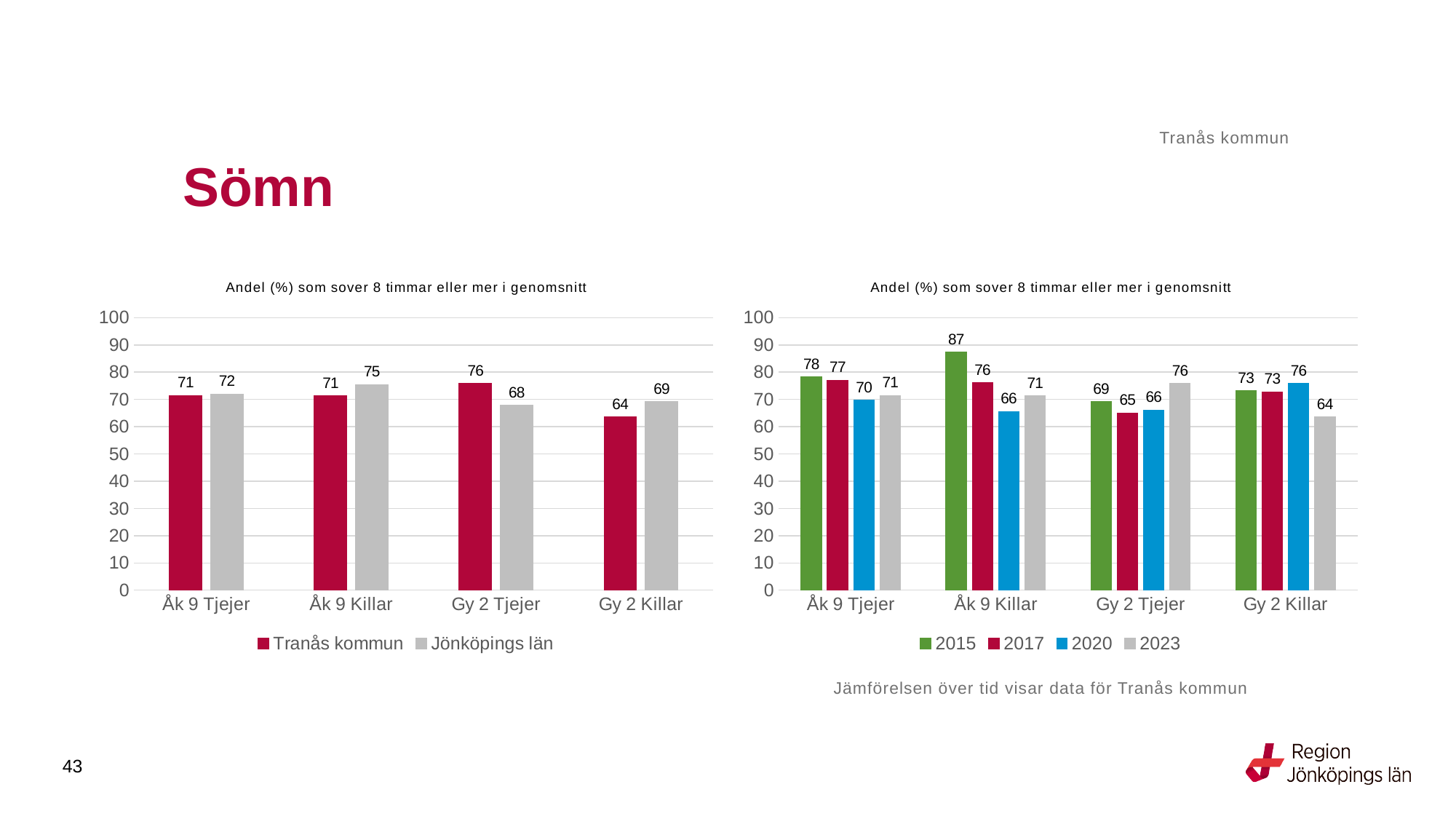
In the left chart, what is the difference between Tranås kommun and Jönköpings län for Gy 2 Tjejer? 8 In the right chart, what is the value for 2023 for Gy 2 Killar? 64 In the left chart, which category has the lowest value for Tranås kommun? Gy 2 Killar In the right chart, what is the difference between the 2015 and 2023 values for Åk 9 Killar? 16 In the right chart, how many series does the legend list? 4 In the left chart, what is the value for Tranås kommun for Gy 2 Tjejer? 76 In the left chart, how many series does the legend list? 2 In the left chart, what is the value for Jönköpings län for Åk 9 Killar? 75 What kind of chart is the right chart? Bar chart In the right chart, what is the value for 2015 for Åk 9 Killar? 87 In the left chart, which is larger for Gy 2 Killar: Tranås kommun or Jönköpings län? Jönköpings län In the right chart, which year has the highest value for Gy 2 Tjejer? 2023